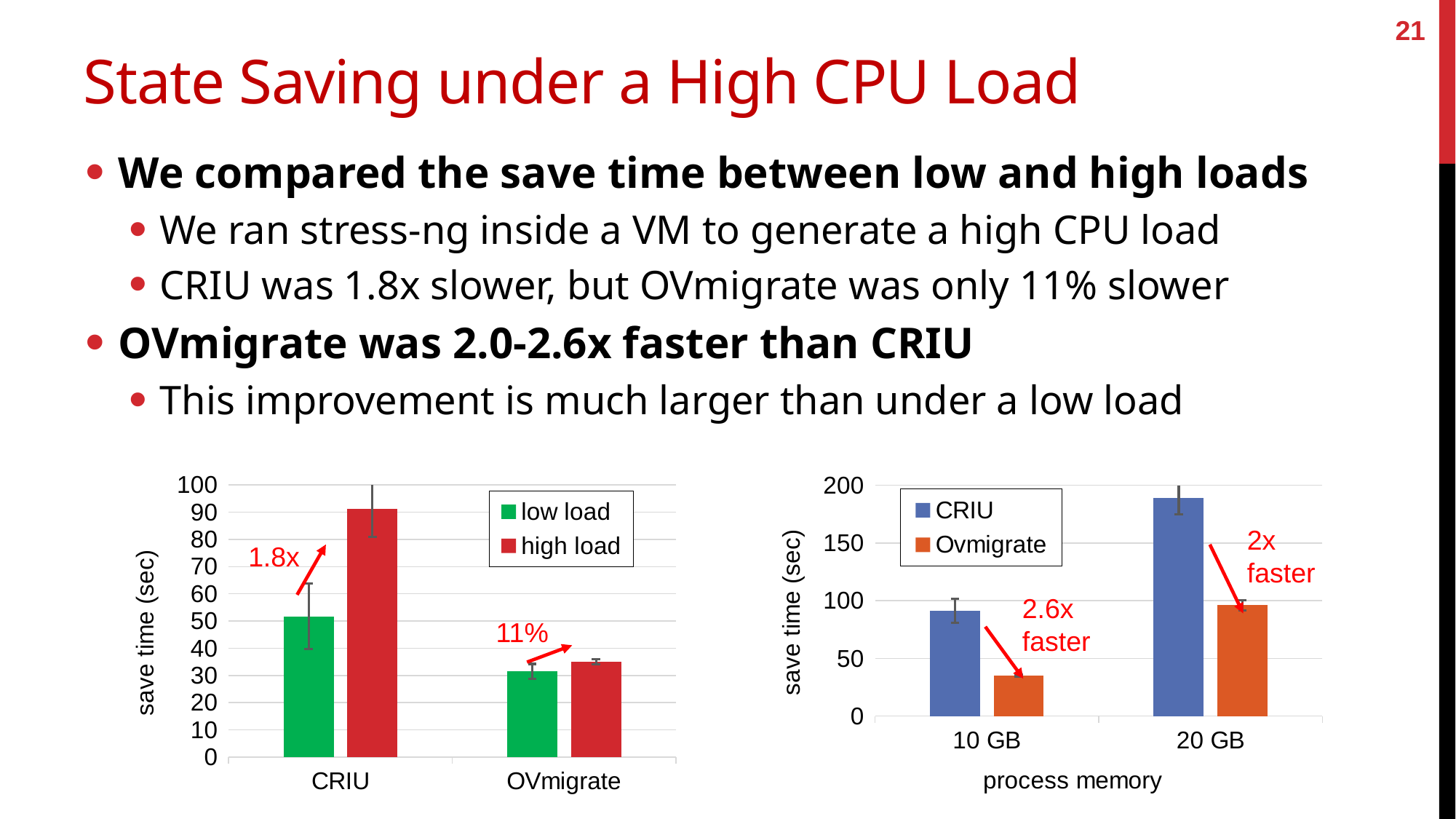
In the chart on the right, is the Ovmigrate value at 10 GB greater or less than 50? less In the chart on the left, how many categories are shown on the x axis? 2 In the chart on the right, does the CRIU save time rise or fall from 10 GB to 20 GB? rise In the chart on the left, which is larger: the low load value for CRIU or the high load value for OVmigrate? low load value for CRIU In the chart on the right, what are the two series listed in the legend? CRIU and Ovmigrate What kind of chart is the chart on the left of the slide? bar chart In the chart on the left, how many series does the legend list? 2 In the chart on the right, is the CRIU value at 20 GB greater or less than 150? greater In the chart on the left, is the low load value for CRIU greater or less than 60? less In the chart on the right, what is the label of the x axis? process memory In the chart on the left, which bar is the highest? CRIU high load